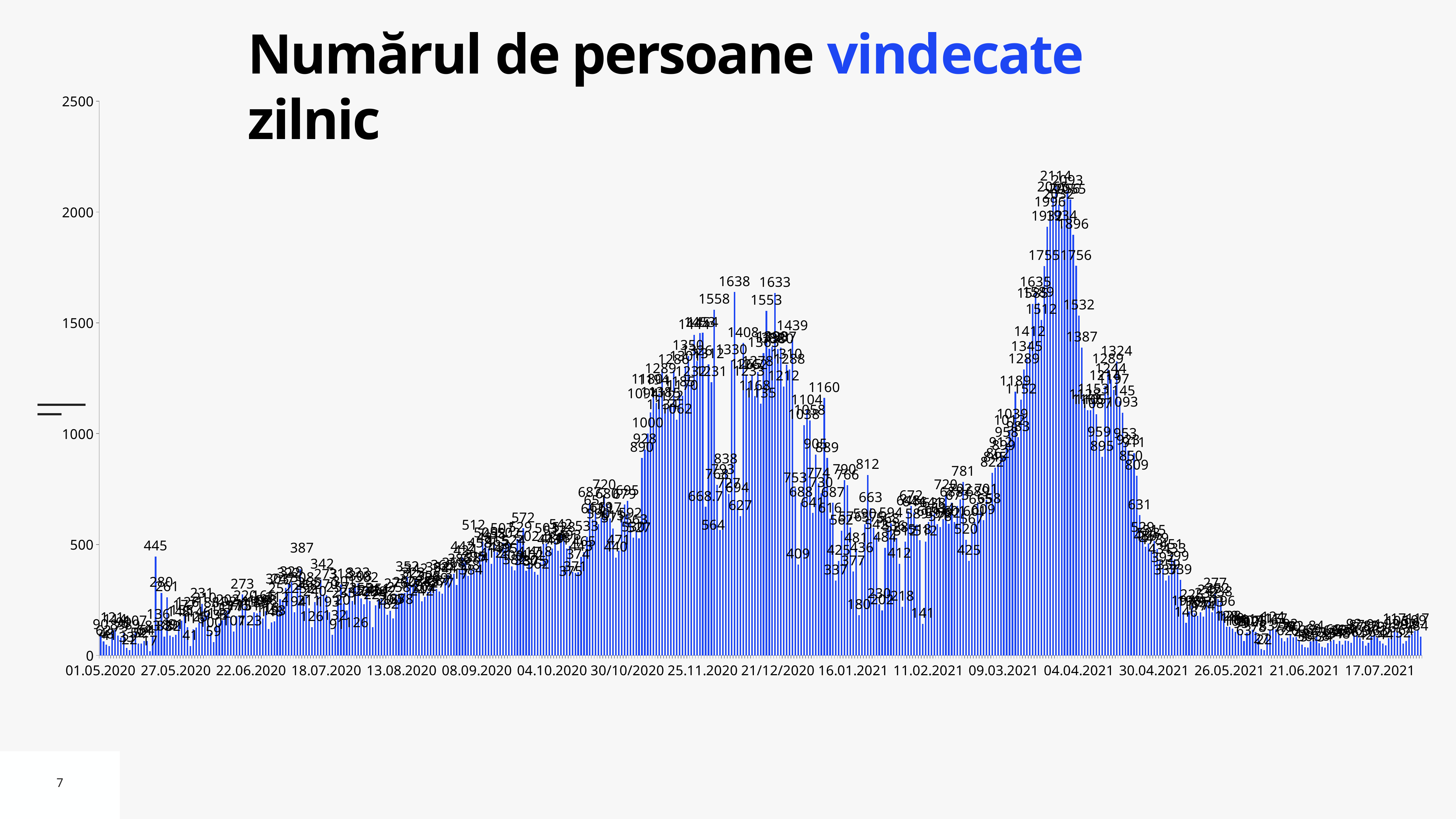
What is the highest value labelled on the chart? 2114 Which is larger: the peak value 1638 in late 2020 or the peak value 2114 in April 2021? 2114 Is the value for 17.07.2021 greater or less than 500? less Do the values rise or fall between 09.03.2021 and 04.04.2021? rise What kind of chart is shown on the slide? bar chart What is the highest value labelled between 01.05.2020 and 22.06.2020? 445 Do the values rise or fall between 04.04.2021 and 26.05.2021? fall What is the difference between the peak value 2114 and the peak value 1638? 476 What is the title of the chart? Numărul de persoane vindecate zilnic Is the value for 01.05.2020 greater or less than 500? less What is the highest value labelled between 30/10/2020 and 16.01.2021? 1638